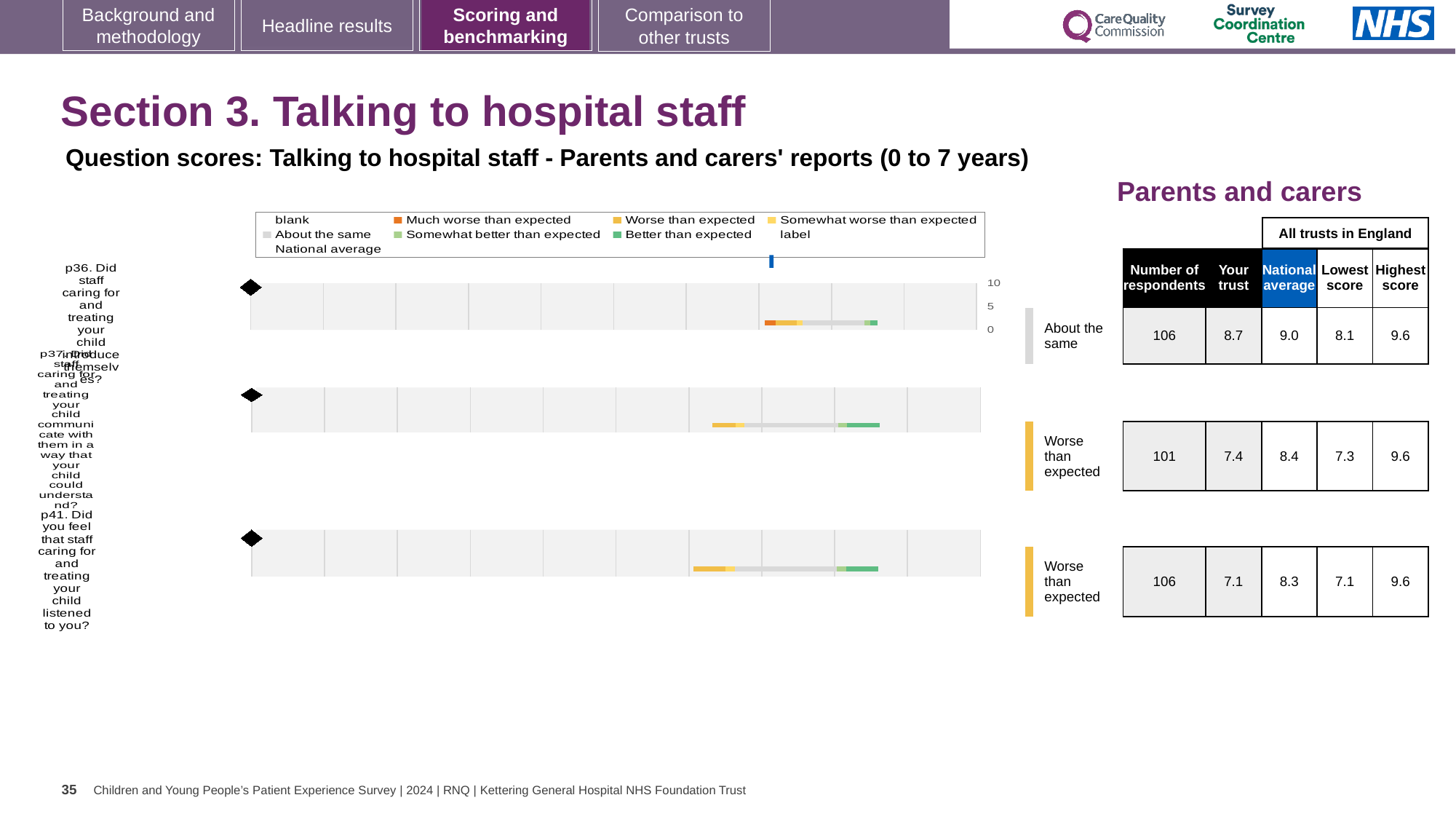
What is the 'Your trust' score for p36 (Did staff caring for and treating your child introduce themselves?)? 8.7 What is the difference between the national average and the 'Your trust' score for p36? 0.3 Which question has the highest 'Your trust' score? p36 How many respondents answered p37? 101 What kind of chart is shown on the slide? bar chart For p37, which is larger: the 'Your trust' score or the national average? National average How many entries does the chart legend list? 9 What is the highest value shown on the chart's score axis? 10 Which question has the lowest 'Your trust' score? p41 What is the benchmark category shown for p41? Worse than expected How many questions (categories) are plotted in the chart? 3 What is the national average score for p41 (Did you feel that staff caring for and treating your child listened to you?)? 8.3